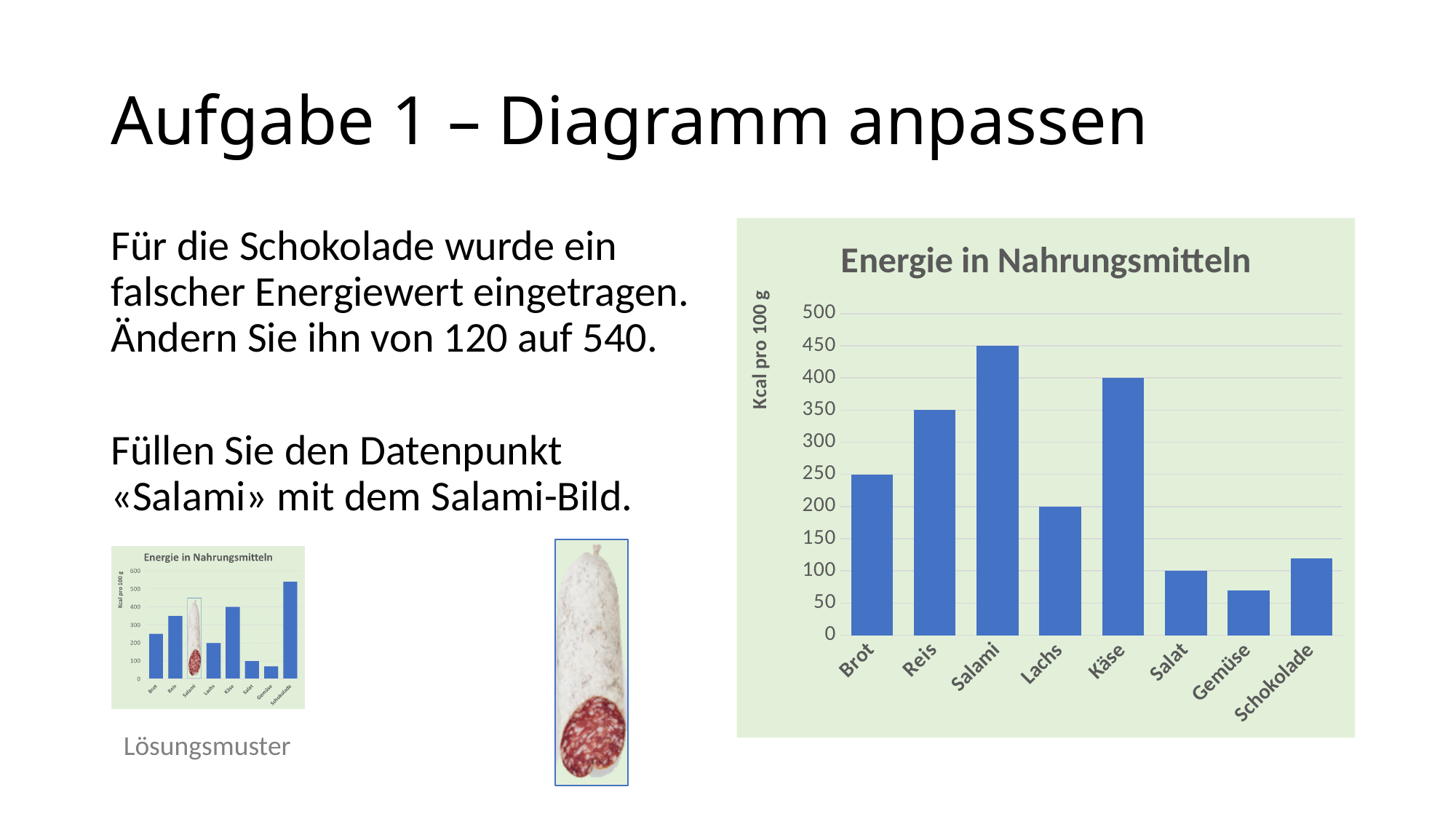
In the large chart "Energie in Nahrungsmitteln", what is the difference between the values for Salami and Käse? 50 In the large chart "Energie in Nahrungsmitteln", what is the label on the vertical axis? Kcal pro 100 g In the large chart "Energie in Nahrungsmitteln", is the value for Gemüse greater or less than 100? less In the large chart "Energie in Nahrungsmitteln", is the value for Schokolade greater or less than 150? less In the large chart "Energie in Nahrungsmitteln", which category has the highest value? Salami In the large chart "Energie in Nahrungsmitteln", which is larger, the value for Reis or the value for Lachs? Reis In the large chart "Energie in Nahrungsmitteln", what is the value for Salami? 450 In the large chart "Energie in Nahrungsmitteln", how many food categories are plotted on the x axis? 8 In the large chart "Energie in Nahrungsmitteln", what is the value for Brot? 250 In the large chart titled "Energie in Nahrungsmitteln", what kind of chart is shown? bar chart In the large chart "Energie in Nahrungsmitteln", which category has the lowest value? Gemüse In the large chart "Energie in Nahrungsmitteln", what is the value for Käse? 400